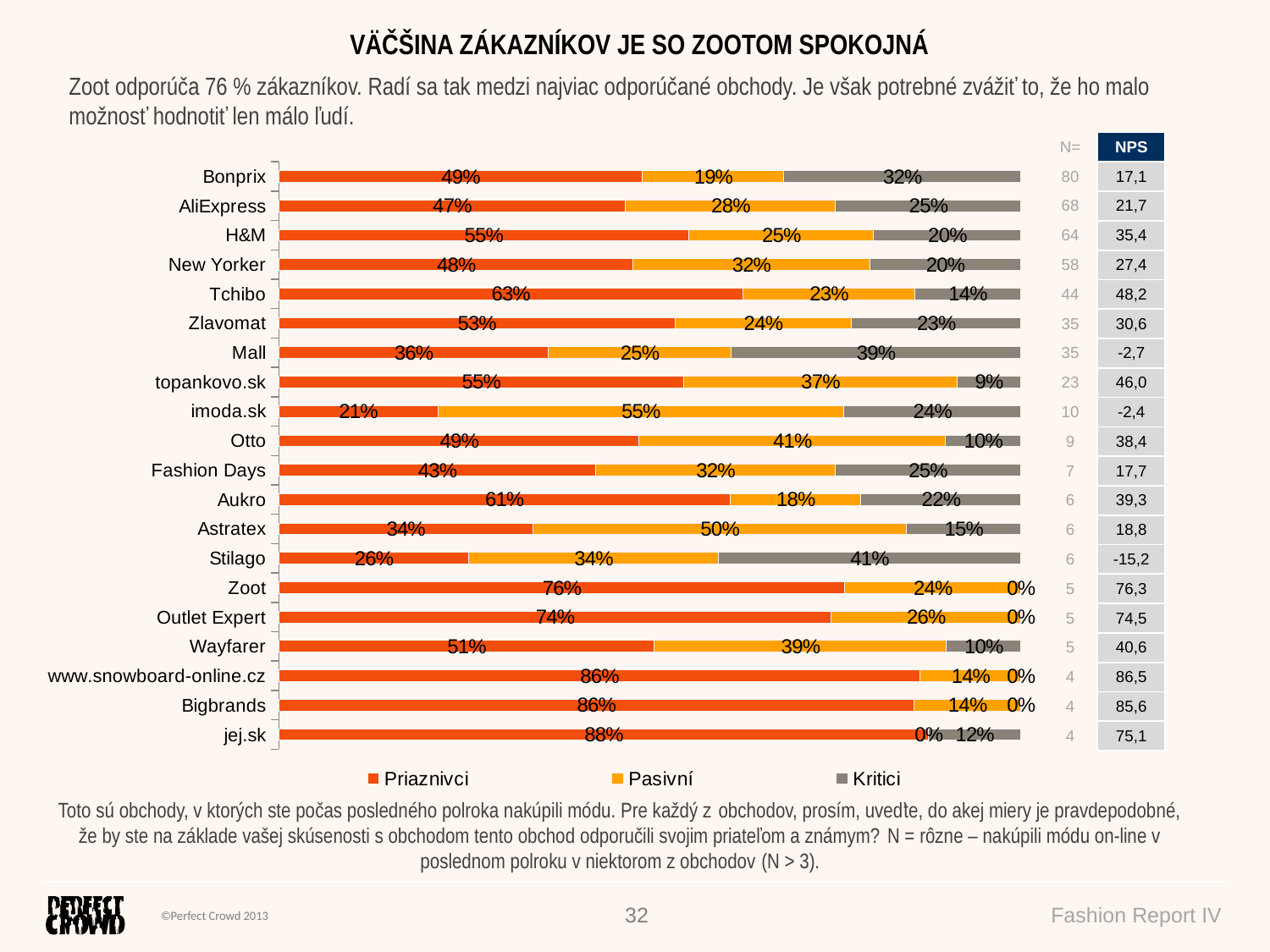
What percentage of Zoot customers are Priaznivci? 76% What is the Kritici share for Mall? 39% How many stores are shown in the chart? 20 Which store has the highest Kritici share? Stilago What is the Pasivní value for Astratex? 50% What type of chart is shown on the slide? Stacked bar chart How many series does the legend list? 3 Which store has the highest Priaznivci share? jej.sk Which store has the lowest Priaznivci share? imoda.sk Which has a larger Priaznivci share, H&M or New Yorker? H&M What are the three legend entries of the chart? Priaznivci, Pasivní, Kritici For Tchibo, how many percentage points higher is the Priaznivci share than the Kritici share? 49 percentage points